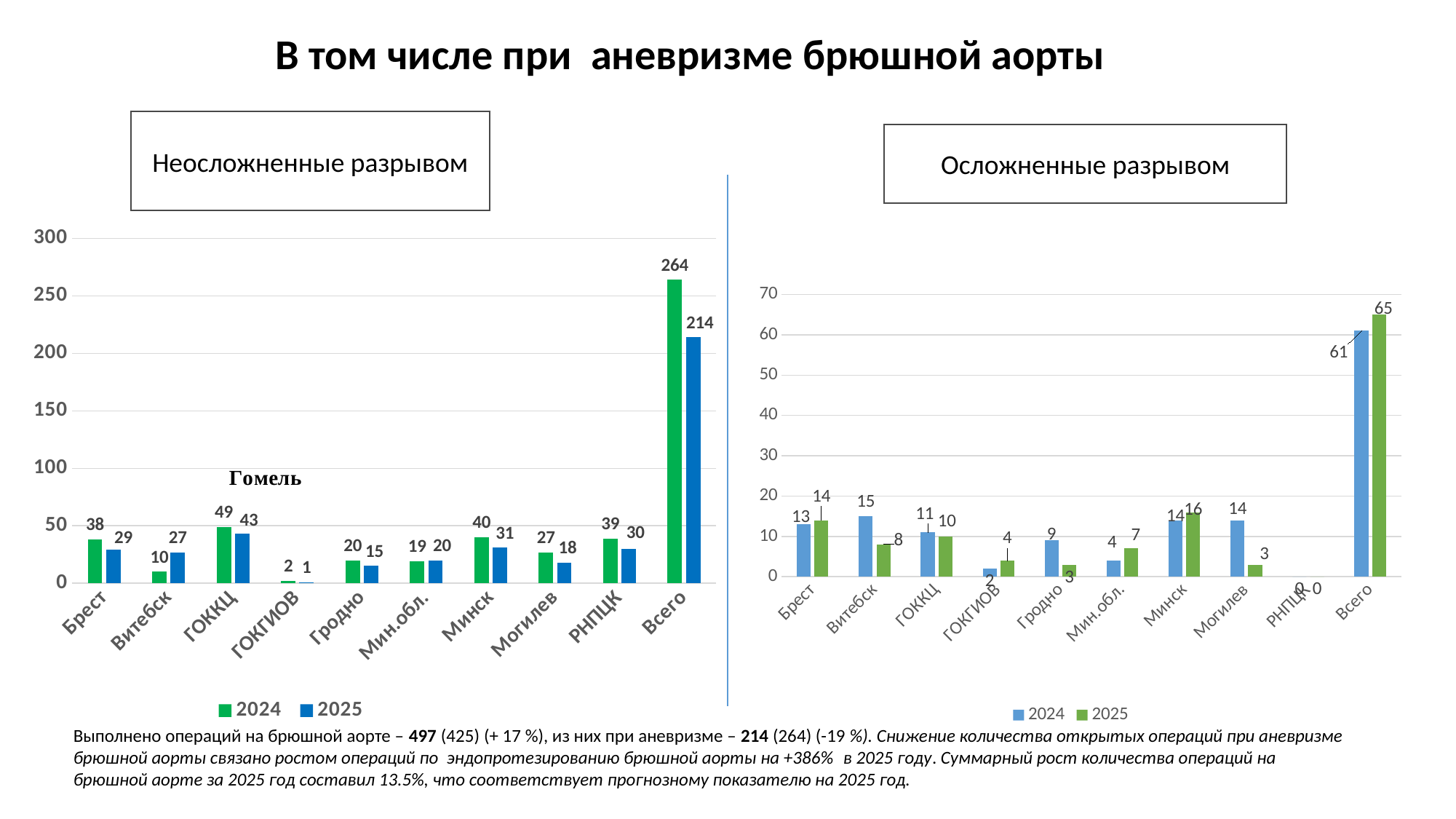
In the 'Неосложненные разрывом' chart, what is the 2024 value for Брест? 38 In the 'Осложненные разрывом' chart, what is the 2024 value for Витебск? 15 In the 'Неосложненные разрывом' chart, which category has the lowest 2025 value? ГОКГИОВ What type of chart is the 'Неосложненные разрывом' chart? Bar chart In the 'Неосложненные разрывом' chart, what is the 2025 value for Всего? 214 In the 'Осложненные разрывом' chart, what is the difference between the 2025 and 2024 values for Всего? 4 In the 'Неосложненные разрывом' chart, is the 2024 value for Витебск greater or less than 50? less In the 'Осложненные разрывом' chart, which is larger for Могилев: the 2024 value or the 2025 value? 2024 In the 'Неосложненные разрывом' chart, which category other than Всего has the highest 2024 value? ГОККЦ How many series does the legend of the 'Осложненные разрывом' chart list? 2 In the 'Неосложненные разрывом' chart, what is the difference between the 2024 and 2025 values for Всего? 50 In the 'Осложненные разрывом' chart, what is the 2025 value for Минск? 16